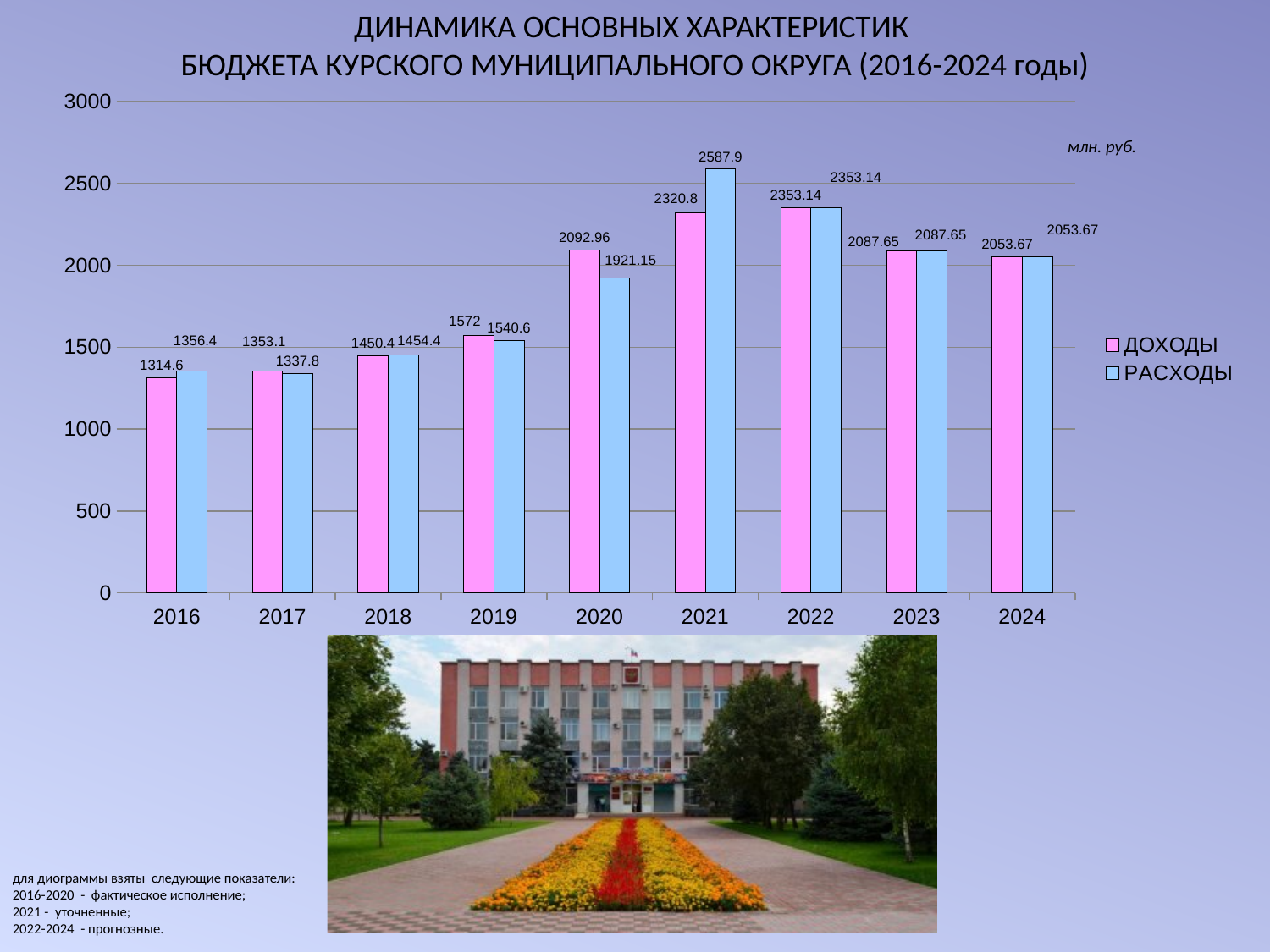
What is the value of ДОХОДЫ for 2024? 2053.67 What kind of chart is shown on the slide? bar chart Is the value of РАСХОДЫ for 2021 greater or less than 2500? greater How many series does the legend list? 2 In which year is ДОХОДЫ the lowest? 2016 What is the difference between ДОХОДЫ and РАСХОДЫ in 2020? 171.81 What is the value of ДОХОДЫ for 2020? 2092.96 How many years are shown on the x axis? 9 In 2019, which is larger, ДОХОДЫ or РАСХОДЫ? ДОХОДЫ In which year is РАСХОДЫ the highest? 2021 What is the difference between РАСХОДЫ and ДОХОДЫ in 2021? 267.1 What is the value of РАСХОДЫ for 2016? 1356.4